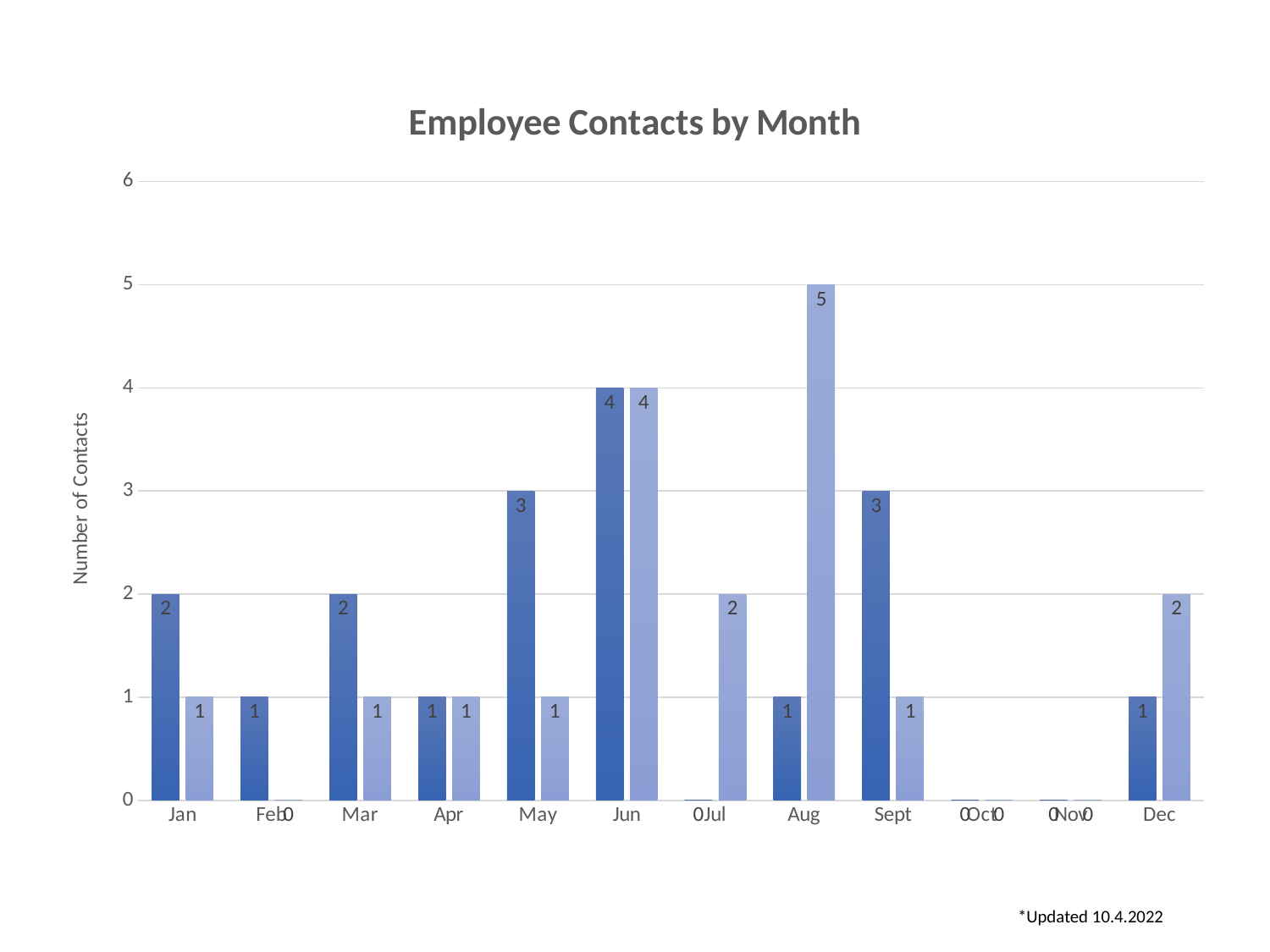
What is the difference between the light blue bar for Aug and the dark blue bar for Aug? 4 Which is larger, the dark blue bar for Sept or the dark blue bar for Dec? Sept How many months are shown on the x axis of the chart? 12 What is the title of the chart? Employee Contacts by Month What is the value of the light blue bar for Jul? 2 What type of chart is shown on the slide? bar chart Which month has the tallest bar in the chart? Aug What is the value of the light blue bar for Aug? 5 What is the value of the dark blue bar for May? 3 What is the value of the light blue bar for Dec? 2 What is the value of the dark blue bar for Jun? 4 What is the label on the vertical axis of the chart? Number of Contacts